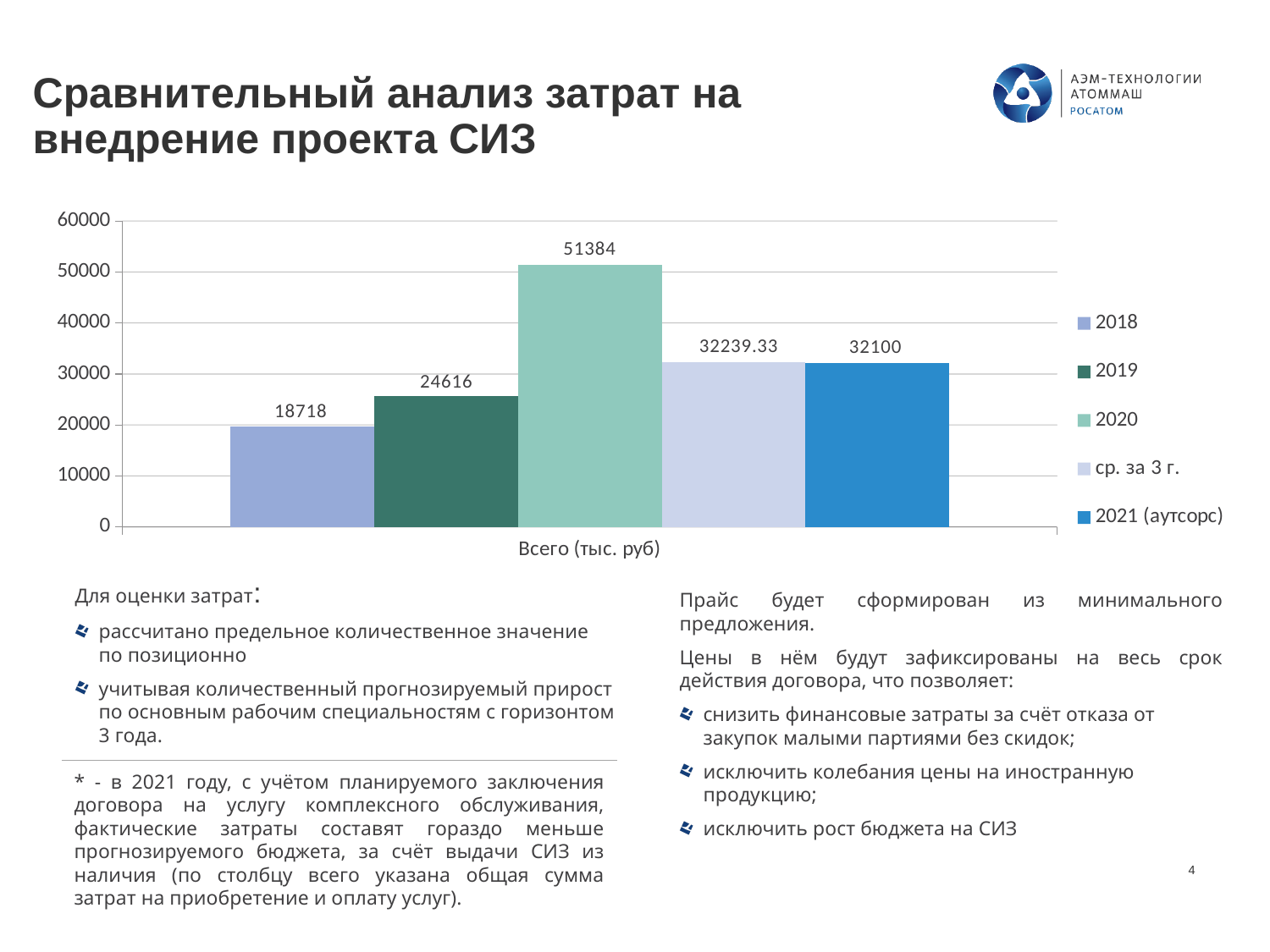
What is the value for 2020 in the chart? 51384 What kind of chart is shown on the slide? bar chart What is the value for 2021 (аутсорс)? 32100 How many series does the legend list? 5 What is the difference between the values for 2019 and 2018? 5898 Is the value for 2020 greater or less than 50000? greater Which series has the lowest value in the chart? 2018 What is the value for the series 'ср. за 3 г.'? 32239.33 Which is larger, the value for 2019 or the value for 2021 (аутсорс)? 2021 (аутсорс) What is the difference between the values for 2020 and 2021 (аутсорс)? 19284 Which series has the highest value in the chart? 2020 What is the value for 2018 in the chart? 18718